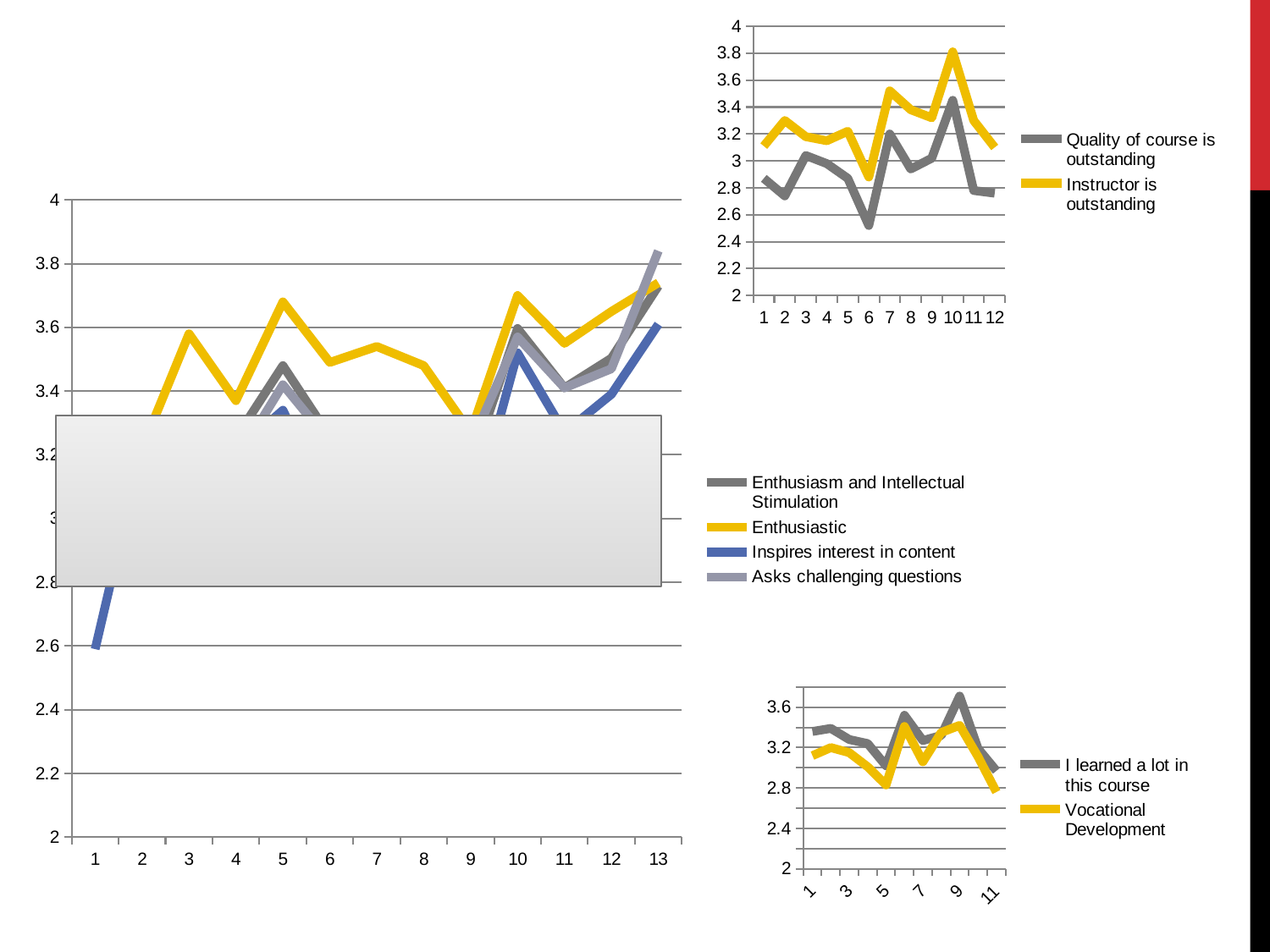
In the top-right chart, at which point is 'Instructor is outstanding' highest? 10 How many points are on the x axis of the large left chart? 13 In the bottom-right chart, which series is higher at point 1, 'I learned a lot in this course' or 'Vocational Development'? I learned a lot in this course What kind of chart is the large chart on the left of the slide? line chart In the large left chart, is the value for 'Enthusiastic' at point 10 greater or less than 3.6? greater How many points are on the x axis of the top-right chart? 12 How many series does the legend of the large left chart list? 4 In the top-right chart, at which point is 'Quality of course is outstanding' lowest? 6 In the large left chart, is the value for 'Inspires interest in content' at point 1 greater or less than 2.8? less In the large left chart, is the value for 'Asks challenging questions' at point 13 greater or less than 3.6? greater How many series does the legend of the top-right chart list? 2